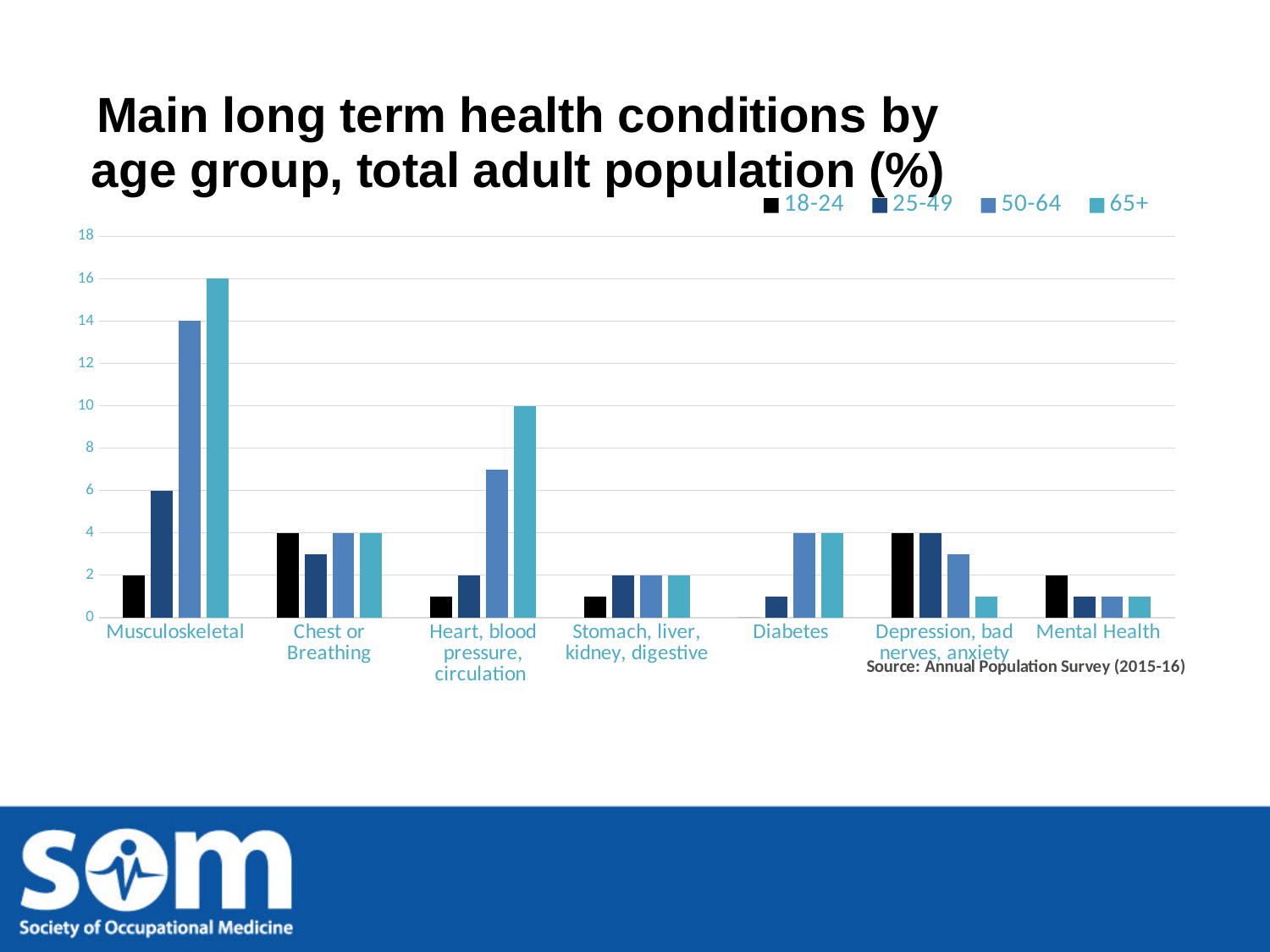
Is the value for the 50-64 age group for Heart, blood pressure, circulation greater or less than 6? greater How many age-group series does the legend list? 4 What is the value for the 65+ age group for Musculoskeletal? 16 What is the value for the 65+ age group for Heart, blood pressure, circulation? 10 How many health condition categories are shown on the x axis? 7 Which health condition has the highest bar on the chart? Musculoskeletal What is the difference between the 65+ and 50-64 values for Musculoskeletal? 2 What type of chart is shown on the slide? Bar chart Which is larger for the 65+ age group: Musculoskeletal or Heart, blood pressure, circulation? Musculoskeletal What is the value for the 18-24 age group for Depression, bad nerves, anxiety? 4 For Musculoskeletal, do the values rise or fall as the age group increases from 18-24 to 65+? Rise What is the value for the 50-64 age group for Musculoskeletal? 14